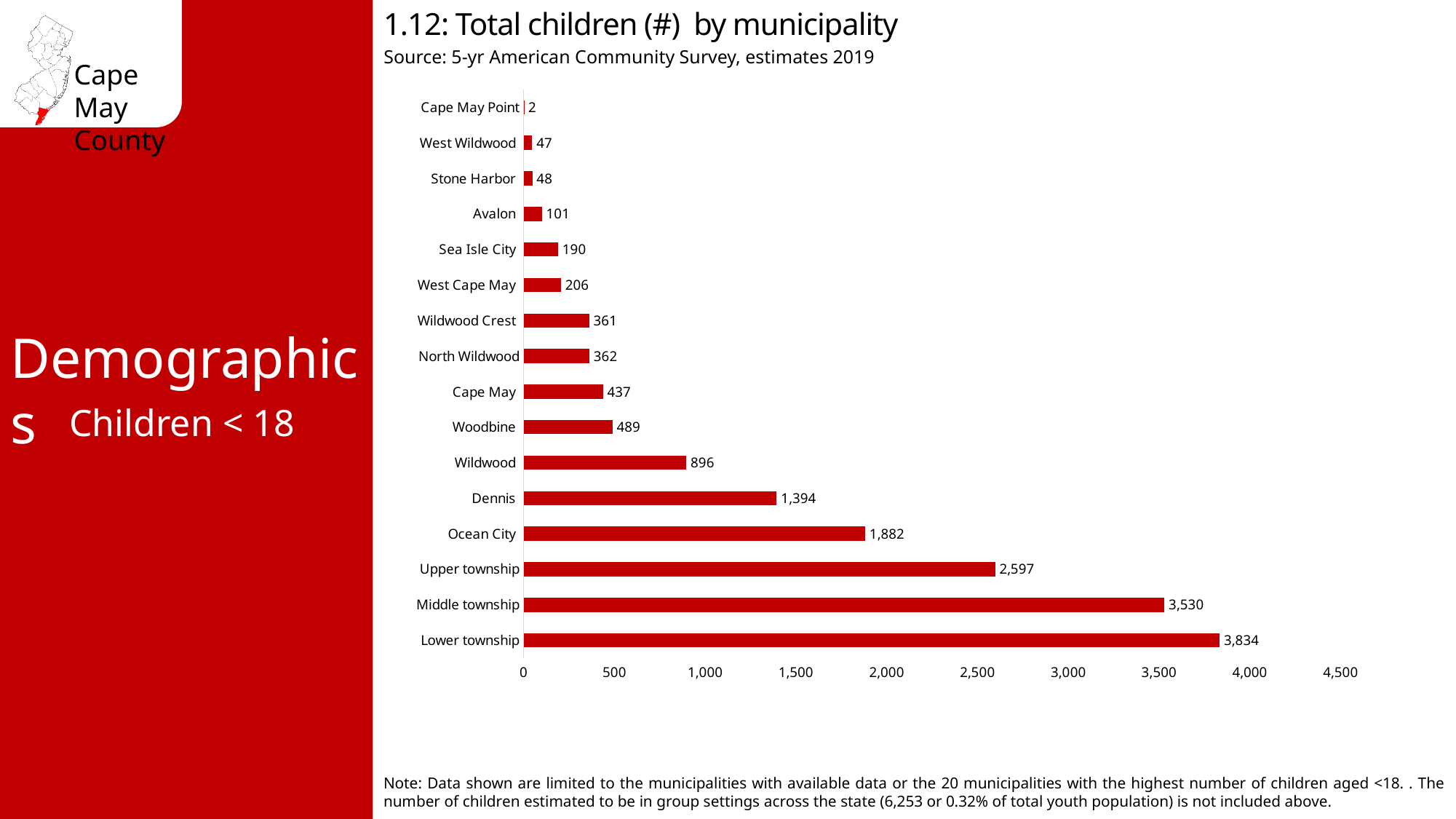
Which municipality has the lowest number of children? Cape May Point What is the difference in the number of children between Lower township and Middle township? 304 What is the difference in the number of children between Ocean City and Dennis? 488 What kind of chart is shown on the slide? bar chart What is the source of the data shown in the chart? 5-yr American Community Survey, estimates 2019 Is the value for Woodbine greater or less than 500? less Which has more children, Upper township or Ocean City? Upper township Which municipality has the highest number of children? Lower township What is the total number of children for Lower township? 3,834 What is the total number of children for Wildwood? 896 What is the total number of children for Cape May Point? 2 How many municipalities are shown in the chart? 16